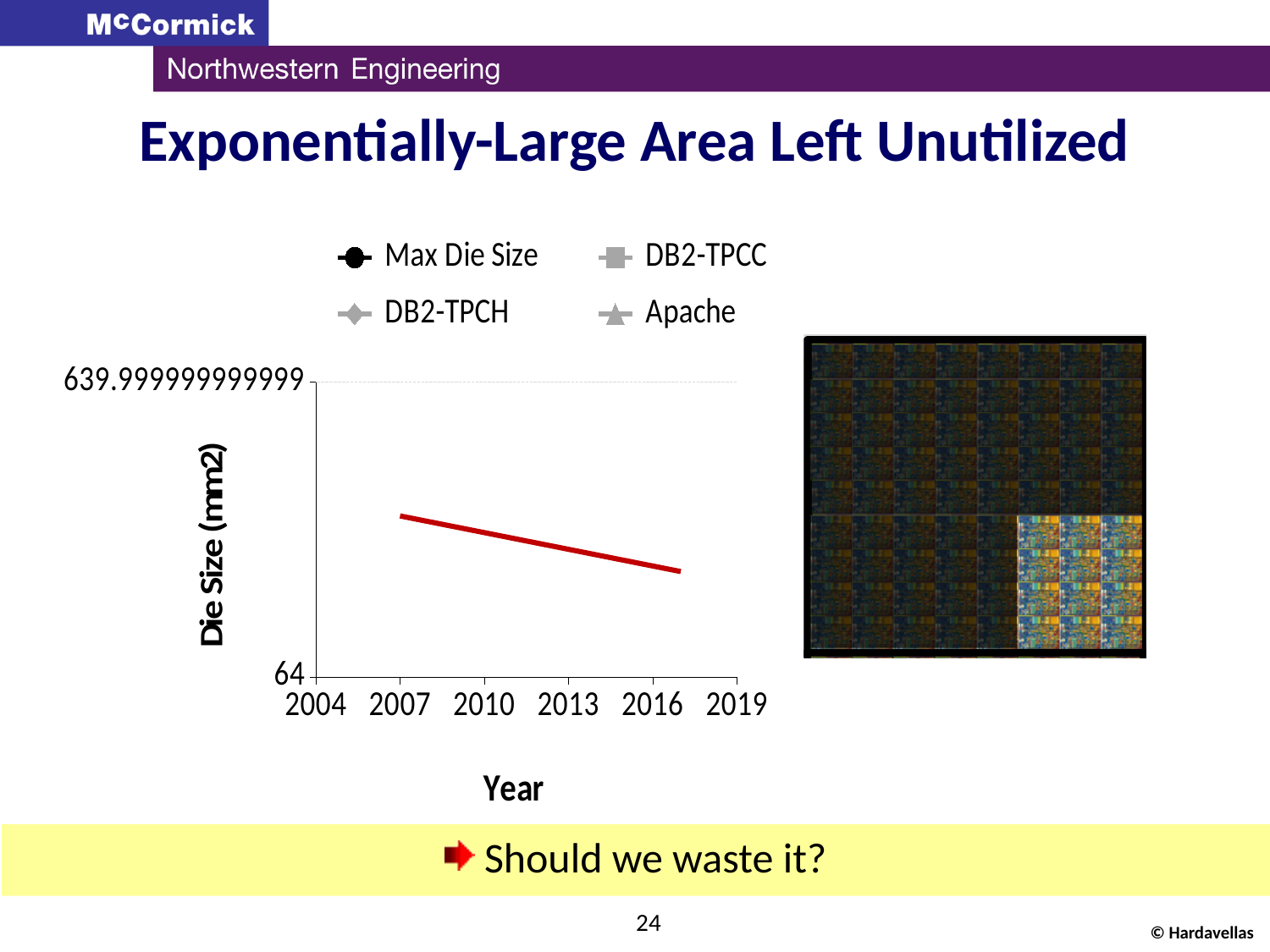
Which legend entry is shown with a black circle marker? Max Die Size Does the red line in the chart rise or fall as the year increases? fall What is the lowest value labelled on the chart's vertical axis? 64 How many year tick labels are shown on the chart's horizontal axis? 6 What kind of chart is shown on the slide? line chart What is the title of the chart's vertical axis? Die Size (mm2) What is the last year labelled on the chart's horizontal axis? 2019 What is the highest value labelled on the chart's vertical axis? 639.999999999999 How many series does the chart's legend list? 4 What is the title of the chart's horizontal axis? Year What is the first year labelled on the chart's horizontal axis? 2004